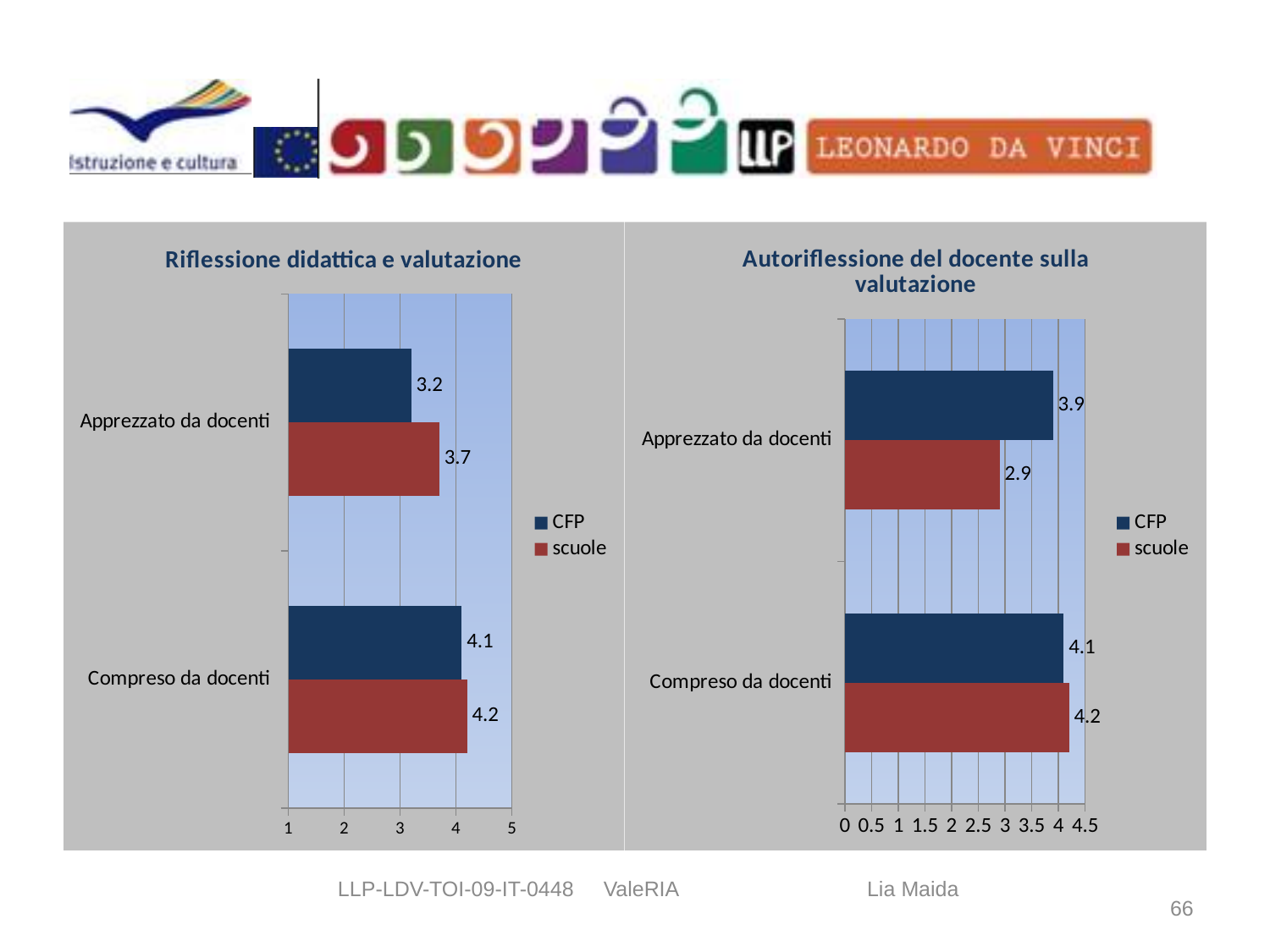
In the chart titled "Riflessione didattica e valutazione", which category has the lowest CFP value? Apprezzato da docenti In the chart titled "Autoriflessione del docente sulla valutazione", what is the CFP value for Apprezzato da docenti? 3.9 In the chart titled "Riflessione didattica e valutazione", what colour are the scuole bars? Red In the chart titled "Autoriflessione del docente sulla valutazione", which series has the larger value for Apprezzato da docenti, CFP or scuole? CFP In the chart titled "Riflessione didattica e valutazione", what is the scuole value for Compreso da docenti? 4.2 In the chart titled "Autoriflessione del docente sulla valutazione", what is the scuole value for Apprezzato da docenti? 2.9 In the chart titled "Riflessione didattica e valutazione", which series has the larger value for Apprezzato da docenti, CFP or scuole? scuole How many series does the legend list in the chart titled "Autoriflessione del docente sulla valutazione"? 2 In the chart titled "Autoriflessione del docente sulla valutazione", what is the difference between the CFP and scuole values for Apprezzato da docenti? 1 In the chart titled "Riflessione didattica e valutazione", what is the difference between the scuole and CFP values for Apprezzato da docenti? 0.5 In the chart titled "Riflessione didattica e valutazione", what is the CFP value for Apprezzato da docenti? 3.2 What kind of chart is the chart titled "Riflessione didattica e valutazione"? Bar chart